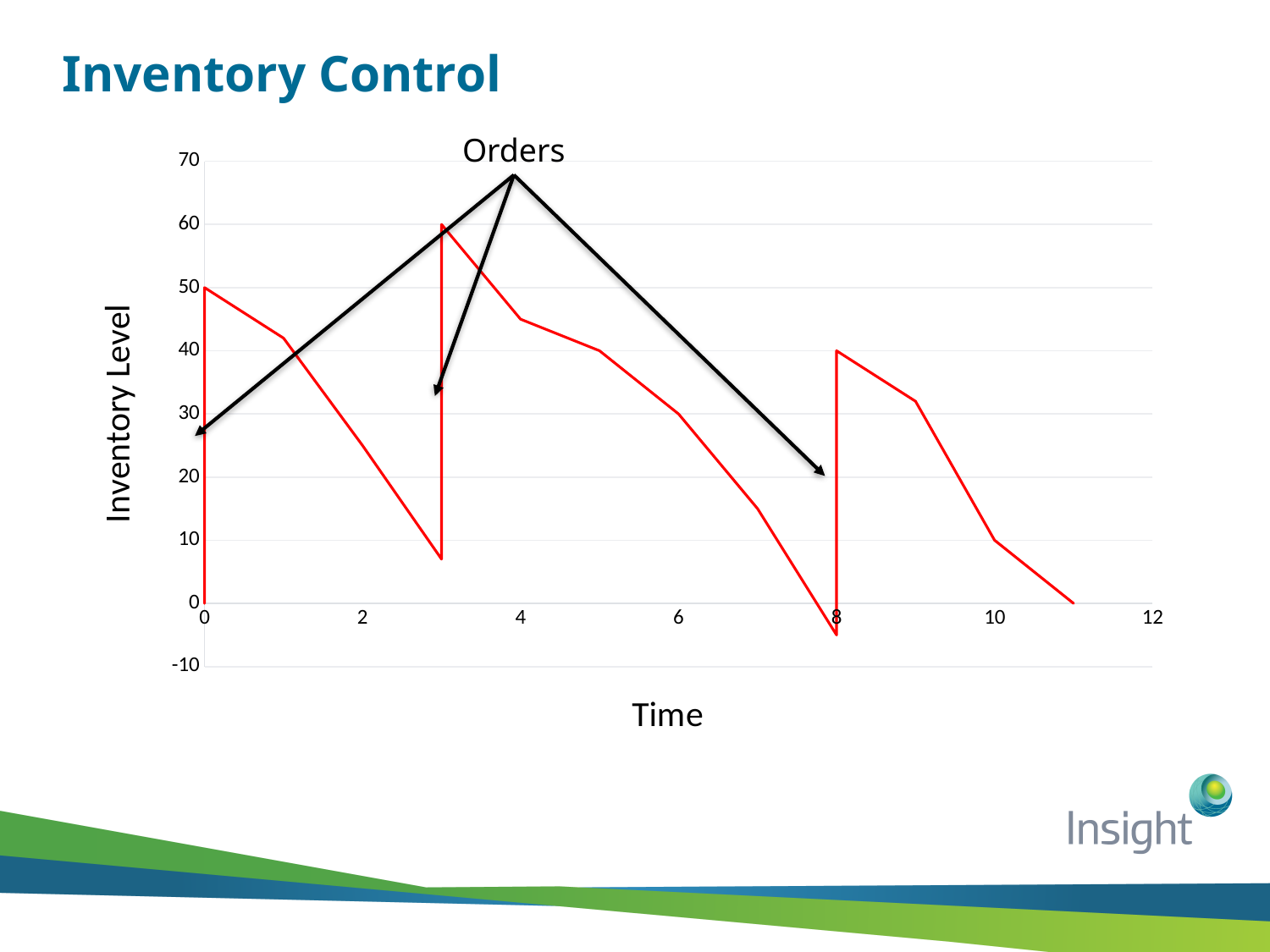
What is the inventory level at time 10? 10 What is the inventory level at time 11? 0 What kind of chart is shown on the slide? line chart What is the label of the horizontal axis? Time Between time 3 and time 8, does the inventory level rise or fall? fall Is the inventory level at time 1 greater or less than 40? greater What inventory level does the line jump up to at time 8? 40 What is the label of the vertical axis? Inventory Level Is the inventory level at time 7 greater or less than 20? less Which is larger: the peak inventory level at time 0 or the peak at time 8? time 0 What is the highest inventory level reached on the chart? 60